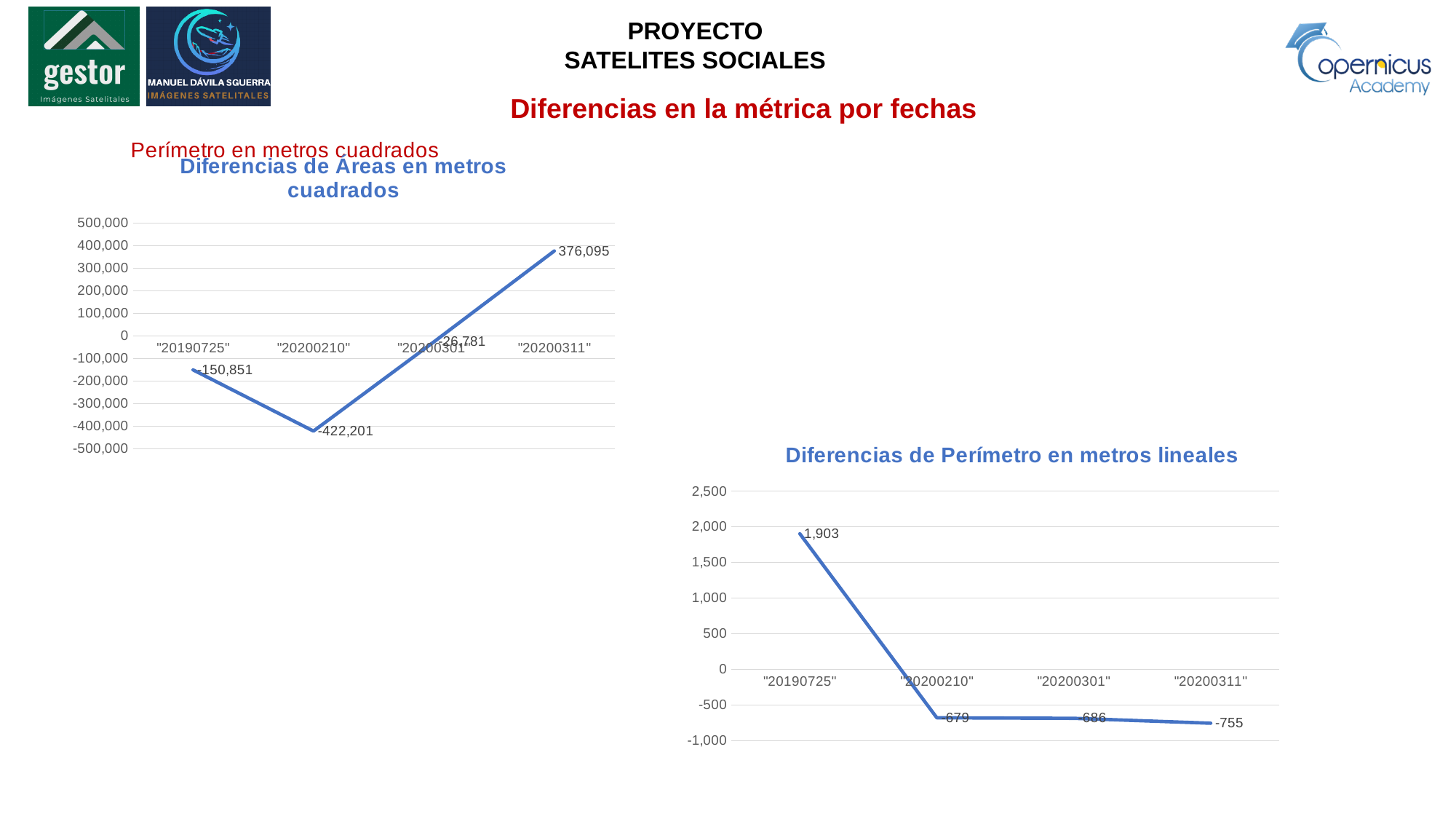
In the chart 'Diferencias de Perímetro en metros lineales', which date has the highest value? "20190725" In the chart 'Diferencias de Perímetro en metros lineales', what is the value for "20200311"? -755 In the chart 'Diferencias de Áreas en metros cuadrados', which date has the lowest value? "20200210" In the chart 'Diferencias de Áreas en metros cuadrados', what is the value for "20200210"? -422,201 In the chart 'Diferencias de Áreas en metros cuadrados', which date has the highest value? "20200311" In the chart 'Diferencias de Áreas en metros cuadrados', how many data points are plotted? 4 In the chart 'Diferencias de Áreas en metros cuadrados', what is the value for "20200311"? 376,095 In the chart 'Diferencias de Perímetro en metros lineales', what is the value for "20190725"? 1,903 In the chart 'Diferencias de Perímetro en metros lineales', is the value for "20190725" greater or less than 1,500? greater In the chart 'Diferencias de Perímetro en metros lineales', what is the difference between the values for "20190725" and "20200311"? 2,658 In the chart 'Diferencias de Áreas en metros cuadrados', is the value for "20200311" larger than the value for "20190725"? Yes What type of chart is 'Diferencias de Perímetro en metros lineales'? Line chart